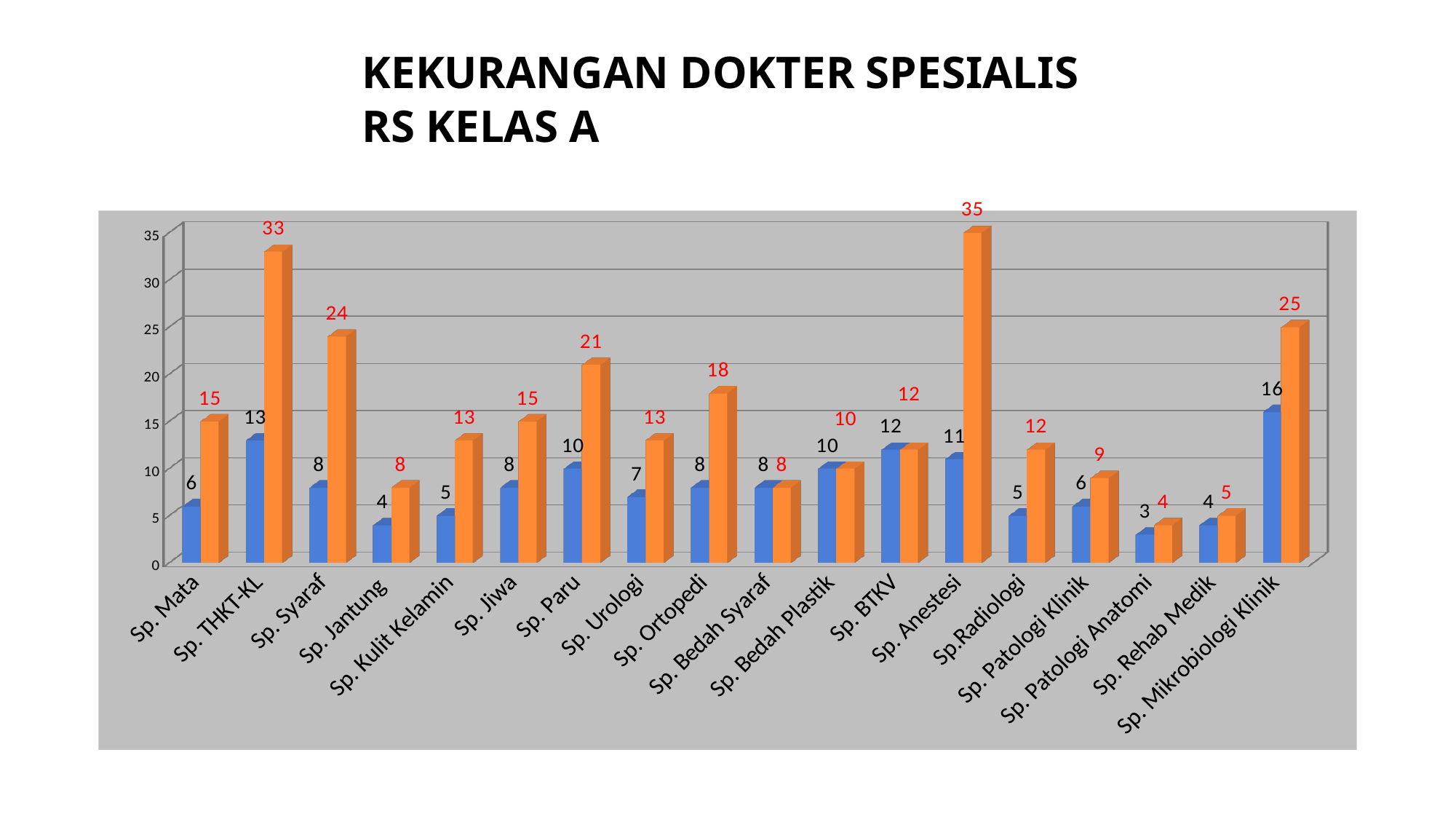
How many categories are shown on the x axis? 18 What is the difference between the orange and blue bars for Sp. Anestesi? 24 What is the value of the orange bar for Sp. THKT-KL? 33 Which category has the lowest blue bar? Sp. Patologi Anatomi What is the value of the blue bar for Sp. Mikrobiologi Klinik? 16 What is the value of the blue bar for Sp. Paru? 10 Which category has the highest orange bar? Sp. Anestesi What is the value of the orange bar for Sp. Anestesi? 35 What kind of chart is shown on the slide? bar chart What is the title of the chart? KEKURANGAN DOKTER SPESIALIS RS KELAS A Which is larger for Sp. Syaraf, the blue bar or the orange bar? the orange bar What is the difference between the orange bars for Sp. THKT-KL and Sp. Syaraf? 9